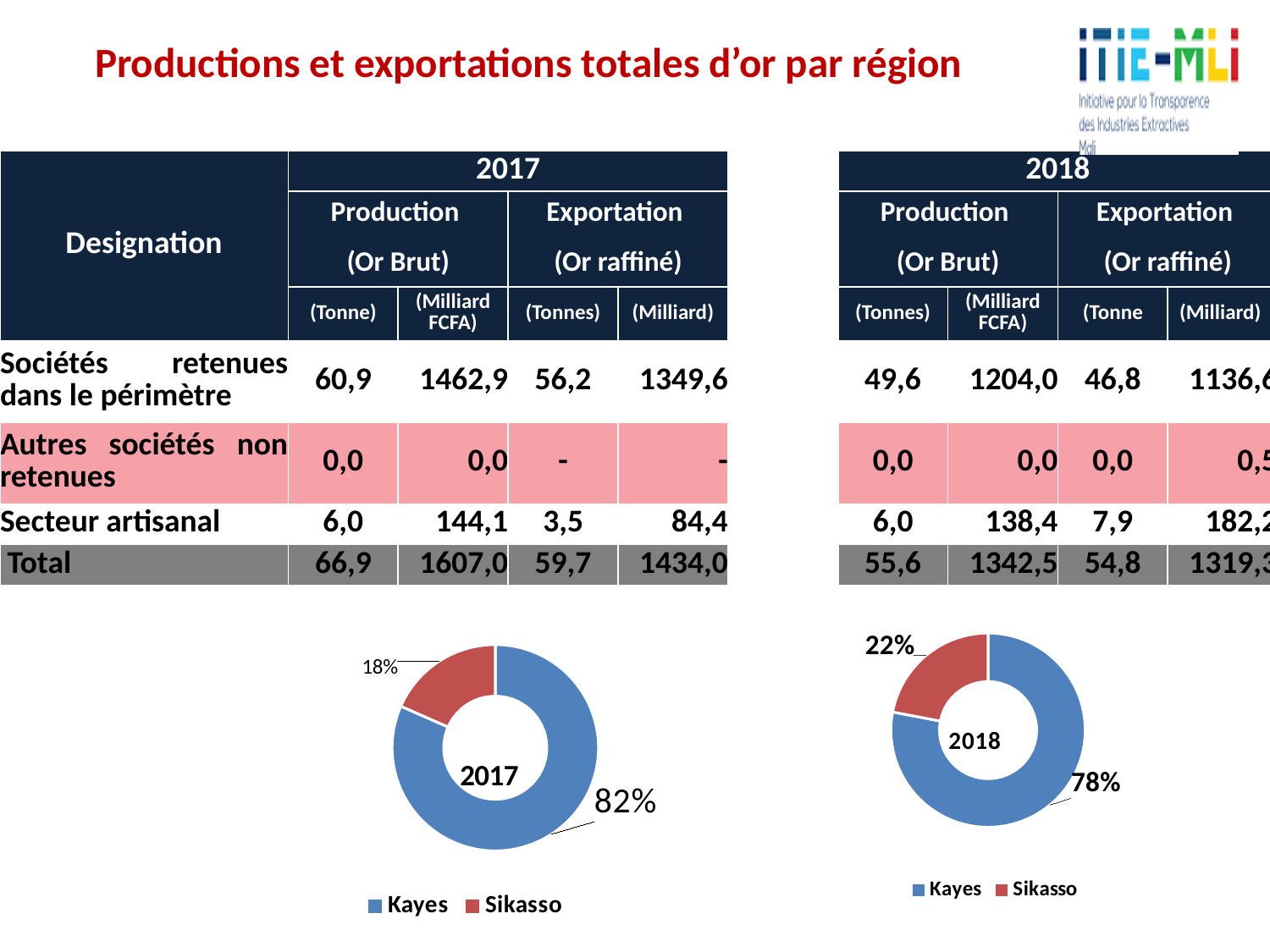
In the 2017 chart, which region has the largest share? Kayes In the 2017 chart, which colour represents Sikasso? Red In the 2018 chart, what share does Kayes have? 78% In the 2018 chart, which is larger, the share for Kayes or the share for Sikasso? Kayes How many regions does the legend of the 2018 chart list? 2 In the 2018 chart, what is the difference between the Kayes and Sikasso shares? 56% In the 2018 chart, what share does Sikasso have? 22% In the 2017 chart, what is the difference between the Kayes and Sikasso shares? 64% In the 2018 chart, which region has the smallest share? Sikasso What kind of chart is the 2017 chart? Doughnut chart In the 2017 chart, what share does Sikasso have? 18%